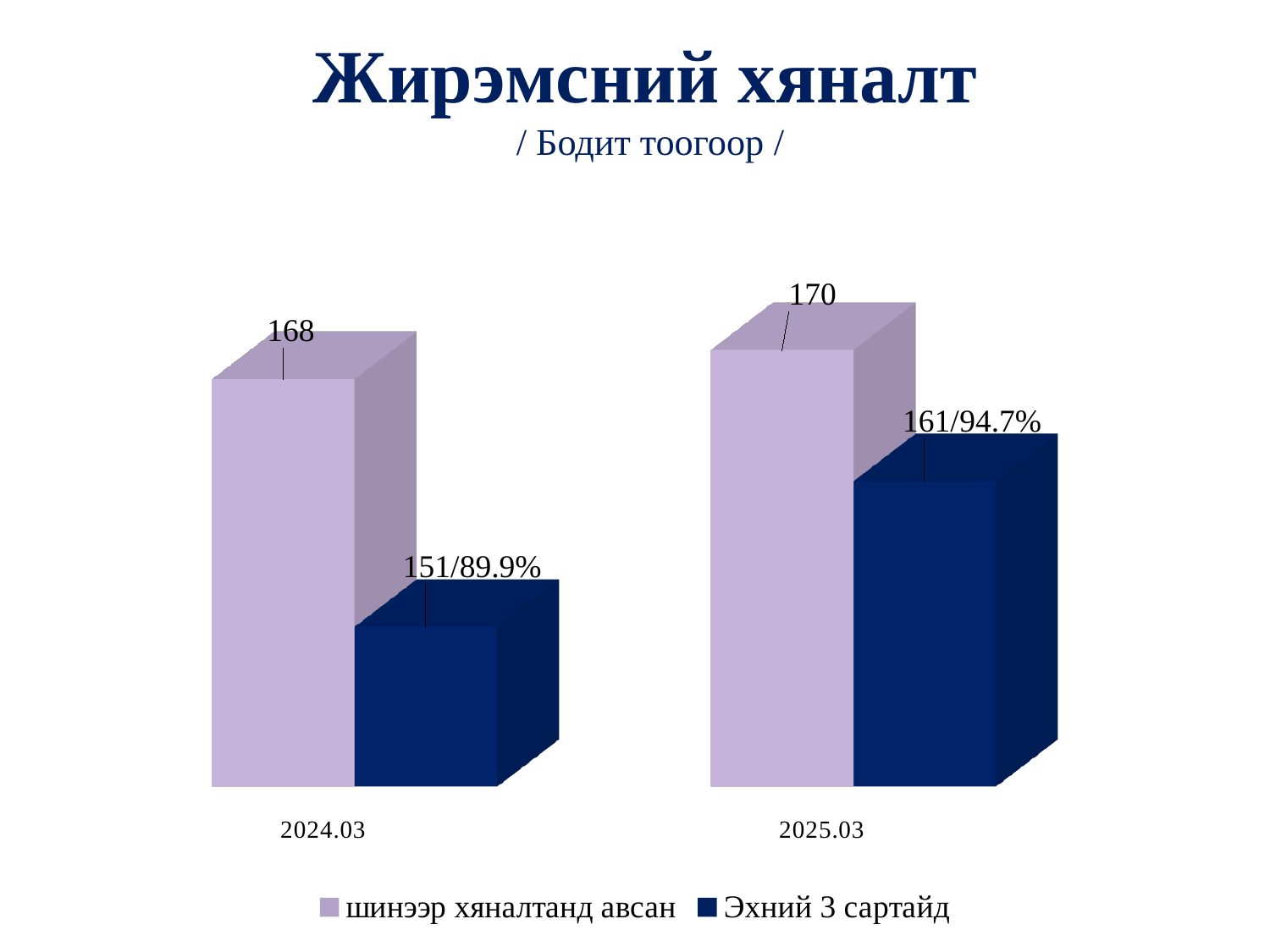
Which category has the higher value for "шинээр хяналтанд авсан"? 2025.03 What is the title of the chart on the slide? Жирэмсний хяналт What is the value for "шинээр хяналтанд авсан" in 2024.03? 168 How many series does the legend list? 2 What data label is shown for "Эхний 3 сартайд" in 2024.03? 151/89.9% What data label is shown for "Эхний 3 сартайд" in 2025.03? 161/94.7% What is the value for "шинээр хяналтанд авсан" in 2025.03? 170 What kind of chart is shown on the slide? bar chart Which category has the lower value for "Эхний 3 сартайд"? 2024.03 Does the value for "Эхний 3 сартайд" rise or fall from 2024.03 to 2025.03? rise How many categories are shown on the x axis? 2 What is the difference between the "шинээр хяналтанд авсан" values for 2025.03 and 2024.03? 2